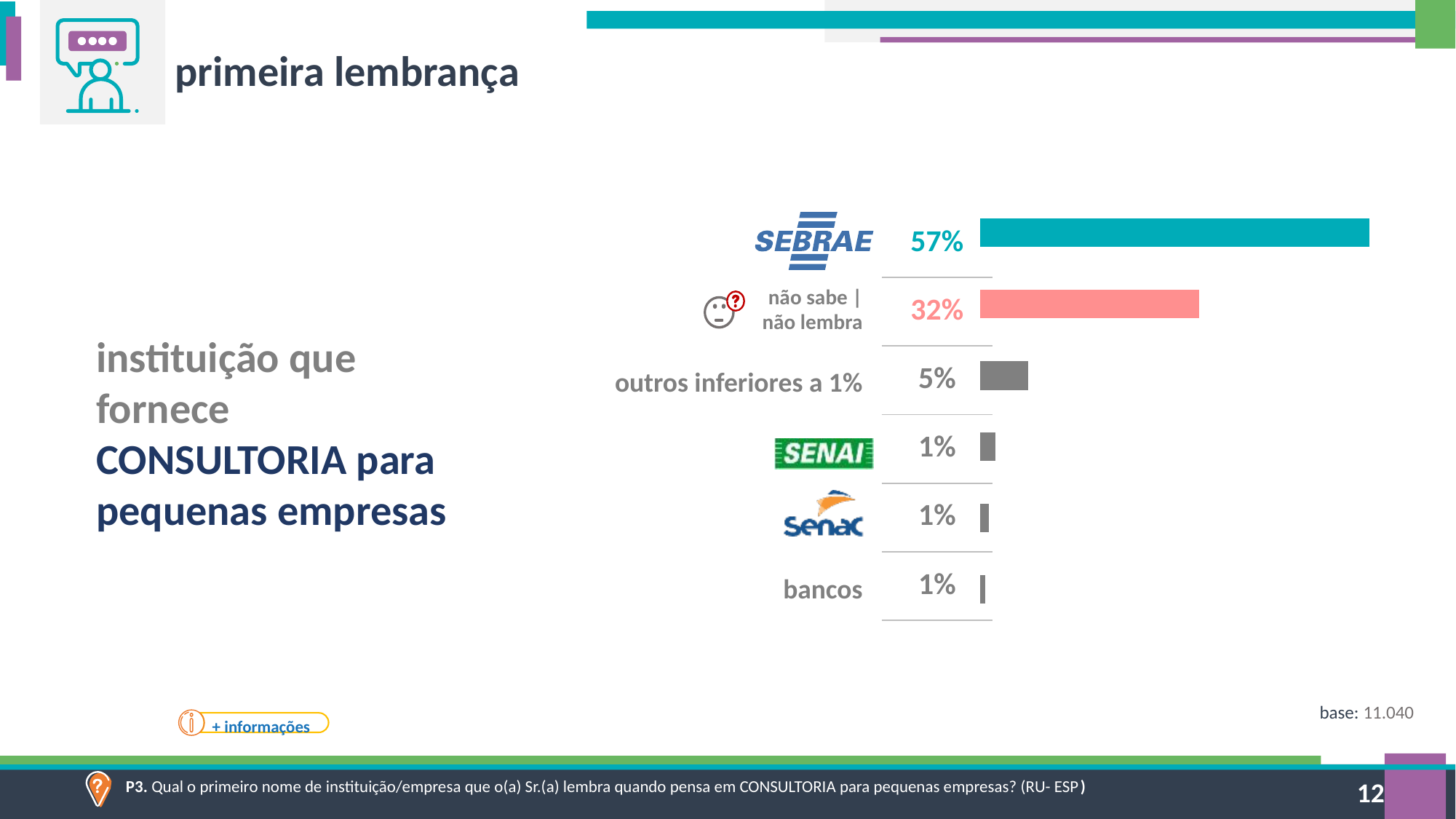
Which is larger, the value for 'outros inferiores a 1%' or the value for SENAI? outros inferiores a 1% What percentage is shown for 'não sabe | não lembra'? 32% What colour is the bar for 'não sabe | não lembra'? pink How many categories are shown in the chart? 6 What percentage is shown for bancos? 1% What percentage is shown for 'outros inferiores a 1%'? 5% What is the difference between the SEBRAE value and the 'não sabe | não lembra' value? 25% What percentage is shown for SEBRAE? 57% What is the difference between the 'não sabe | não lembra' value and the 'outros inferiores a 1%' value? 27% What kind of chart is shown on the slide? bar chart Which is larger, the value for SEBRAE or the value for 'não sabe | não lembra'? SEBRAE Which category has the highest value? SEBRAE